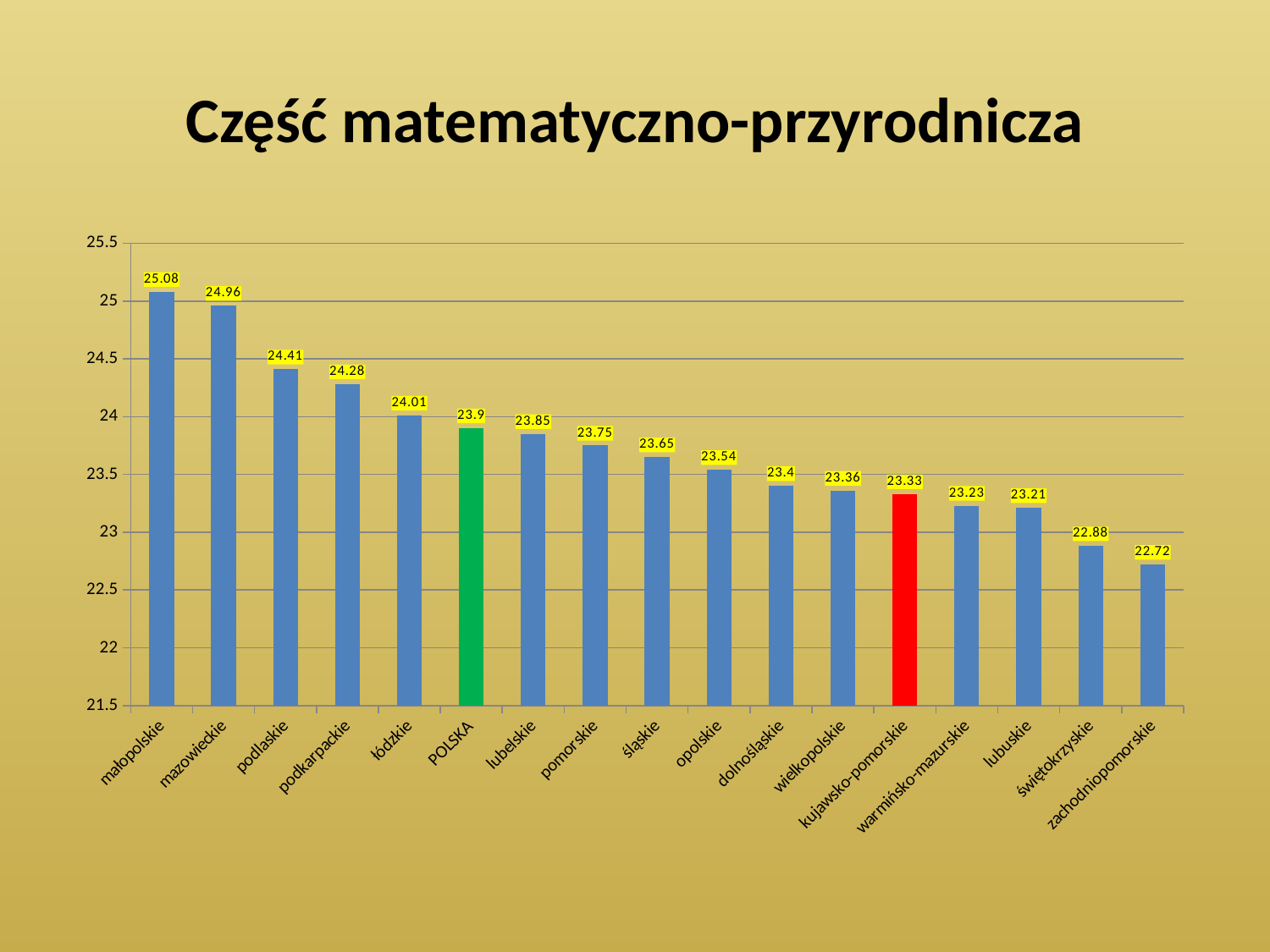
Is the value for świętokrzyskie greater or less than 23? less What is the value for małopolskie? 25.08 What is the difference between the values for małopolskie and zachodniopomorskie? 2.36 Which is larger, the value for podlaskie or the value for lubelskie? podlaskie What kind of chart is shown on the slide? bar chart How many bars are shown in the chart? 17 What is the difference between the values for POLSKA and kujawsko-pomorskie? 0.57 What is the value for kujawsko-pomorskie? 23.33 What is the title of the chart? Część matematyczno-przyrodnicza Which category has the lowest value? zachodniopomorskie What is the value for POLSKA? 23.9 Which category has the highest value? małopolskie